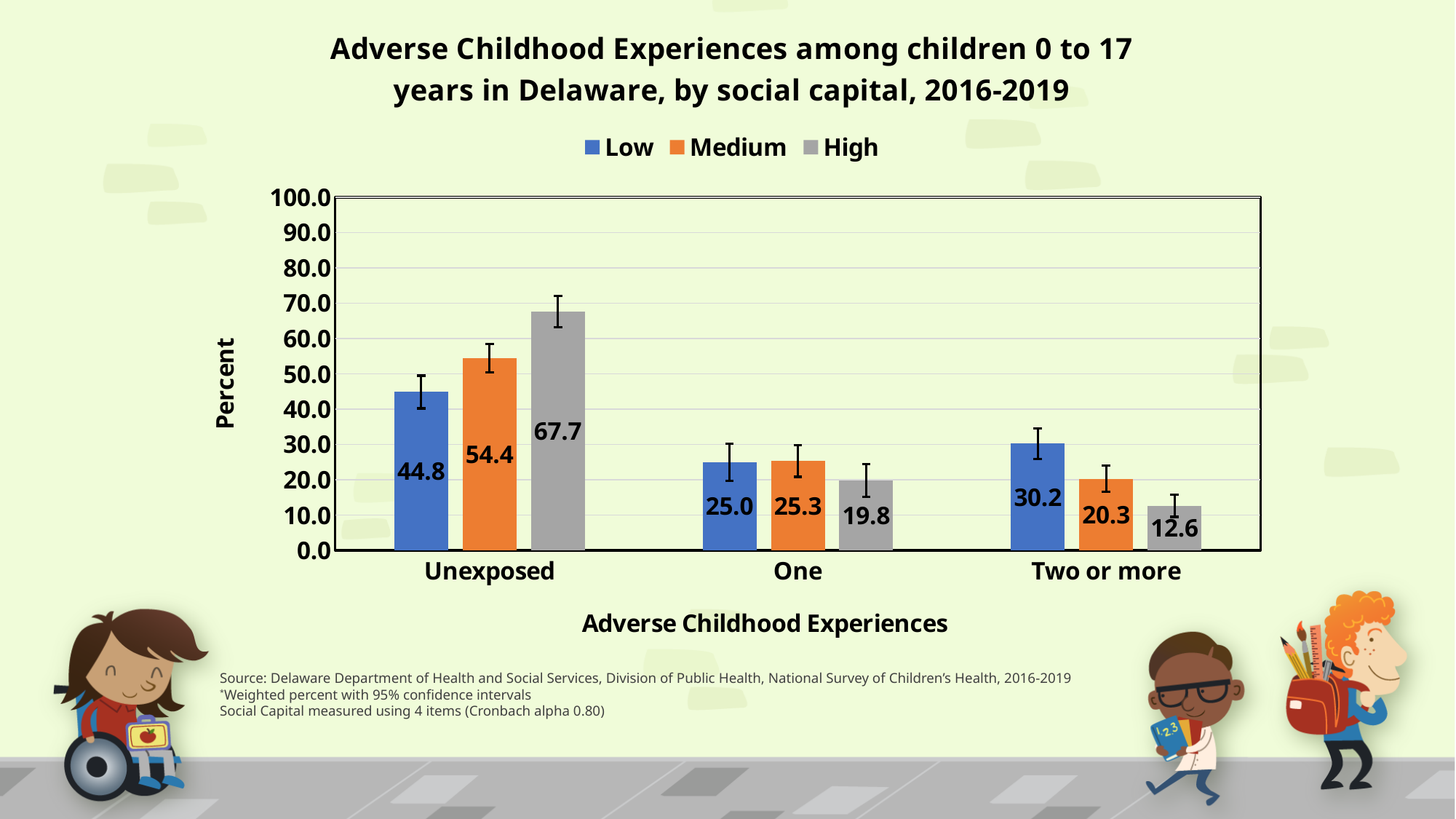
Which is larger in the Two or more category: the Low value or the Medium value? Low What is the value for Medium social capital in the One category? 25.3 What kind of chart is shown on the slide? bar chart What is the label of the y axis? Percent How many series does the legend list? 3 What is the value for Low social capital in the Two or more category? 30.2 Which social capital level has the lowest value in the Two or more category? High What is the value for High social capital in the Unexposed category? 67.7 Is the value for Medium social capital in the Unexposed category greater or less than 50.0? greater Which social capital level has the highest value in the Unexposed category? High What is the difference between the High and Low values in the Unexposed category? 22.9 How many categories are shown on the x axis? 3